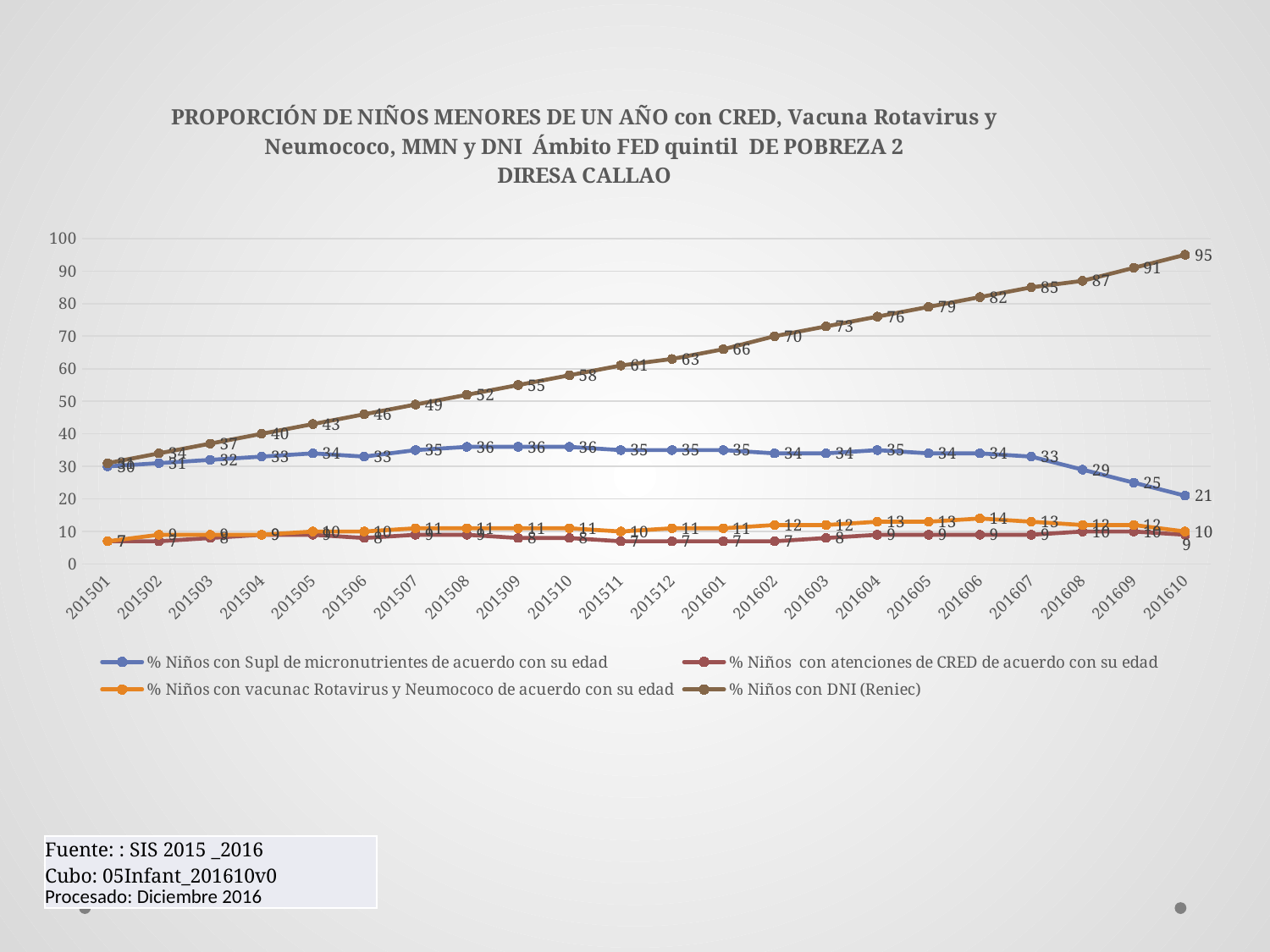
What is the value of % Niños con vacunac Rotavirus y Neumococo de acuerdo con su edad at 201606? 14 What is the value of % Niños con DNI (Reniec) at 201610? 95 Does the % Niños con DNI (Reniec) series rise or fall from 201501 to 201610? rise How many months are plotted along the x axis? 22 In which month does % Niños con DNI (Reniec) reach its highest value? 201610 What is the value of % Niños con Supl de micronutrientes de acuerdo con su edad at 201610? 21 How many series does the legend list? 4 At 201610, which is larger: % Niños con DNI (Reniec) or % Niños con Supl de micronutrientes de acuerdo con su edad? % Niños con DNI (Reniec) What is the difference between the % Niños con DNI (Reniec) value at 201610 and at 201501? 64 Which DIRESA is named in the chart title? DIRESA CALLAO What kind of chart is shown on the slide? line chart Is the value for % Niños con DNI (Reniec) at 201601 greater or less than 60? greater